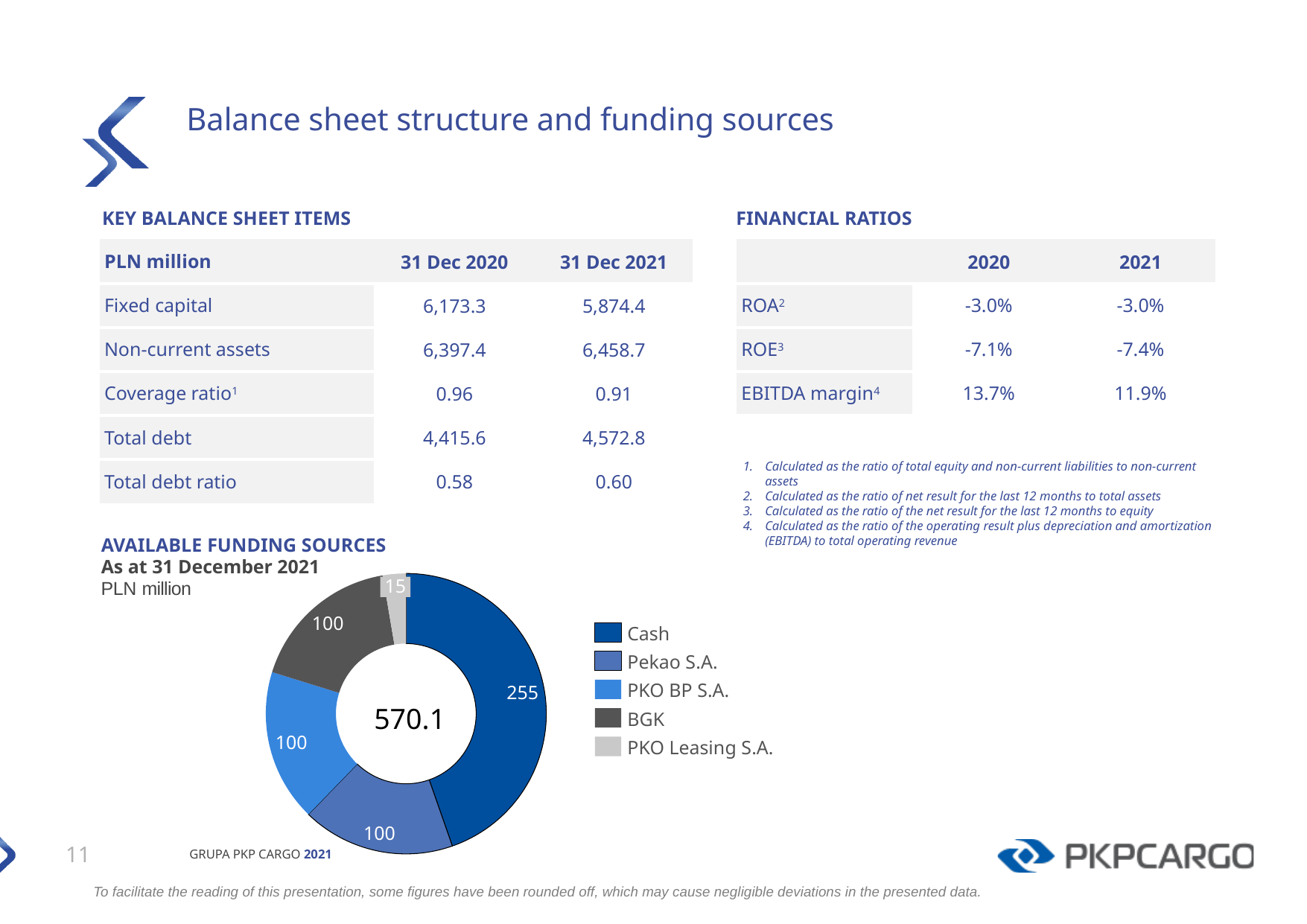
In the Available Funding Sources chart, what is the value for BGK? 100 In the Available Funding Sources chart, which is larger: the value for Cash or the value for Pekao S.A.? Cash In the Available Funding Sources chart, which funding source has the smallest value? PKO Leasing S.A. What kind of chart is the Available Funding Sources chart? doughnut chart What total value is printed in the centre of the Available Funding Sources chart? 570.1 In the Available Funding Sources chart, what is the value for PKO Leasing S.A.? 15 How many entries does the legend of the Available Funding Sources chart list? 5 In the Available Funding Sources chart, what is the difference between the value for Pekao S.A. and the value for PKO Leasing S.A.? 85 In the Available Funding Sources chart, which funding source has the largest value? Cash In the Available Funding Sources chart, what is the difference between the value for Cash and the value for BGK? 155 How many funding sources are shown in the Available Funding Sources chart? 5 In the Available Funding Sources chart, what is the value for Cash? 255